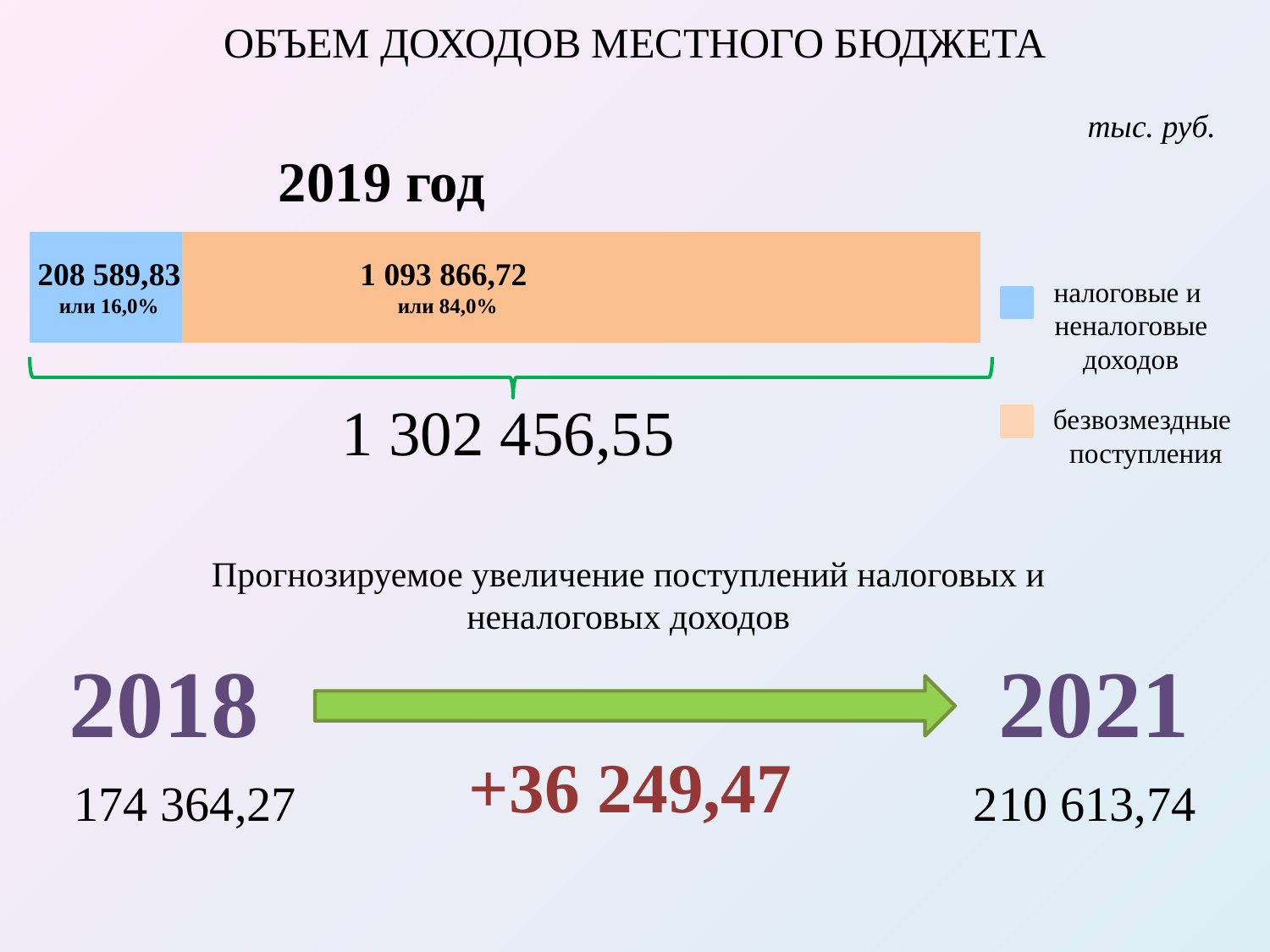
What unit is stated for the values on the slide? тыс. руб. What is the total of the 2019 stacked bar? 1 302 456,55 How many series does the legend list? 2 What share of the 2019 bar do налоговые и неналоговые доходы make up? 16,0% What is the value of the налоговые и неналоговые доходы segment in the 2019 bar? 208 589,83 Which segment of the 2019 bar is larger: налоговые и неналоговые доходы or безвозмездные поступления? безвозмездные поступления What share of the 2019 bar do безвозмездные поступления make up? 84,0% What is the difference between the безвозмездные поступления and налоговые и неналоговые доходы segments in the 2019 bar? 885 276,89 Which segment of the 2019 bar is the smallest? налоговые и неналоговые доходы What colour is the безвозмездные поступления segment in the 2019 bar? orange What kind of chart shows the 2019 budget revenue? stacked bar chart What is the value of the безвозмездные поступления segment in the 2019 bar? 1 093 866,72